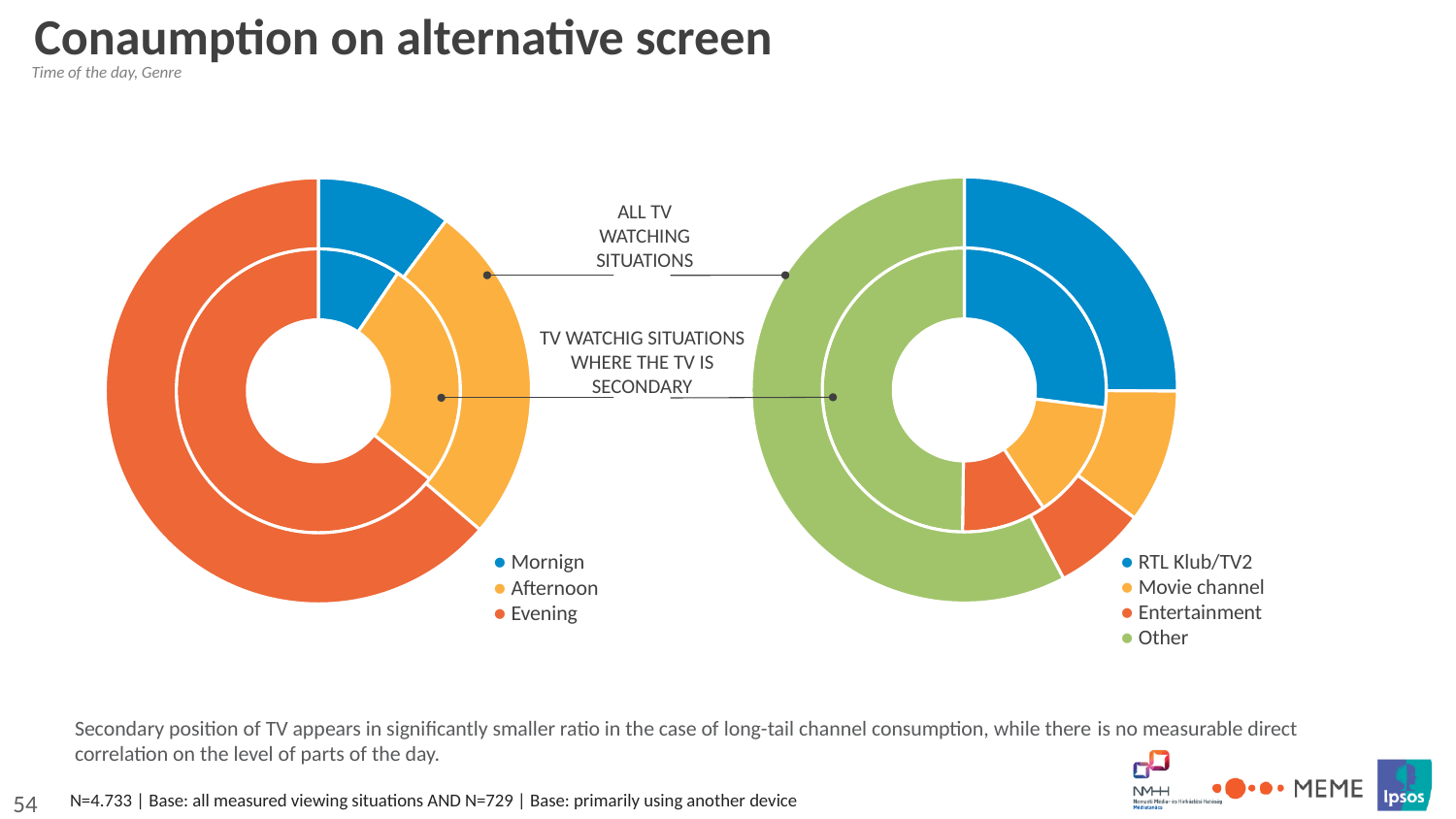
In the right chart (genre), how many categories does the legend list? 4 What kind of chart is the left chart (time of the day)? doughnut chart In the right chart (genre), which category has the largest share in the outer ring (all TV watching situations)? Other In the left chart (time of the day), how many categories does the legend list? 3 In the right chart (genre), in the outer ring, which is larger: the share of RTL Klub/TV2 or the share of Movie channel? RTL Klub/TV2 In the right chart (genre), which category has the largest share in the inner ring (TV watching situations where the TV is secondary)? Other In the left chart (time of the day), which part of the day has the largest share in the inner ring (TV watching situations where the TV is secondary)? Evening In the left chart (time of the day), which part of the day has the smallest share in the outer ring (all TV watching situations)? Mornign In the left chart (time of the day), in the outer ring, which is larger: the share of Afternoon or the share of Mornign? Afternoon What does the inner ring of each chart represent, according to the labels on the slide? TV watching situations where the TV is secondary What kind of chart is the right chart (genre)? doughnut chart